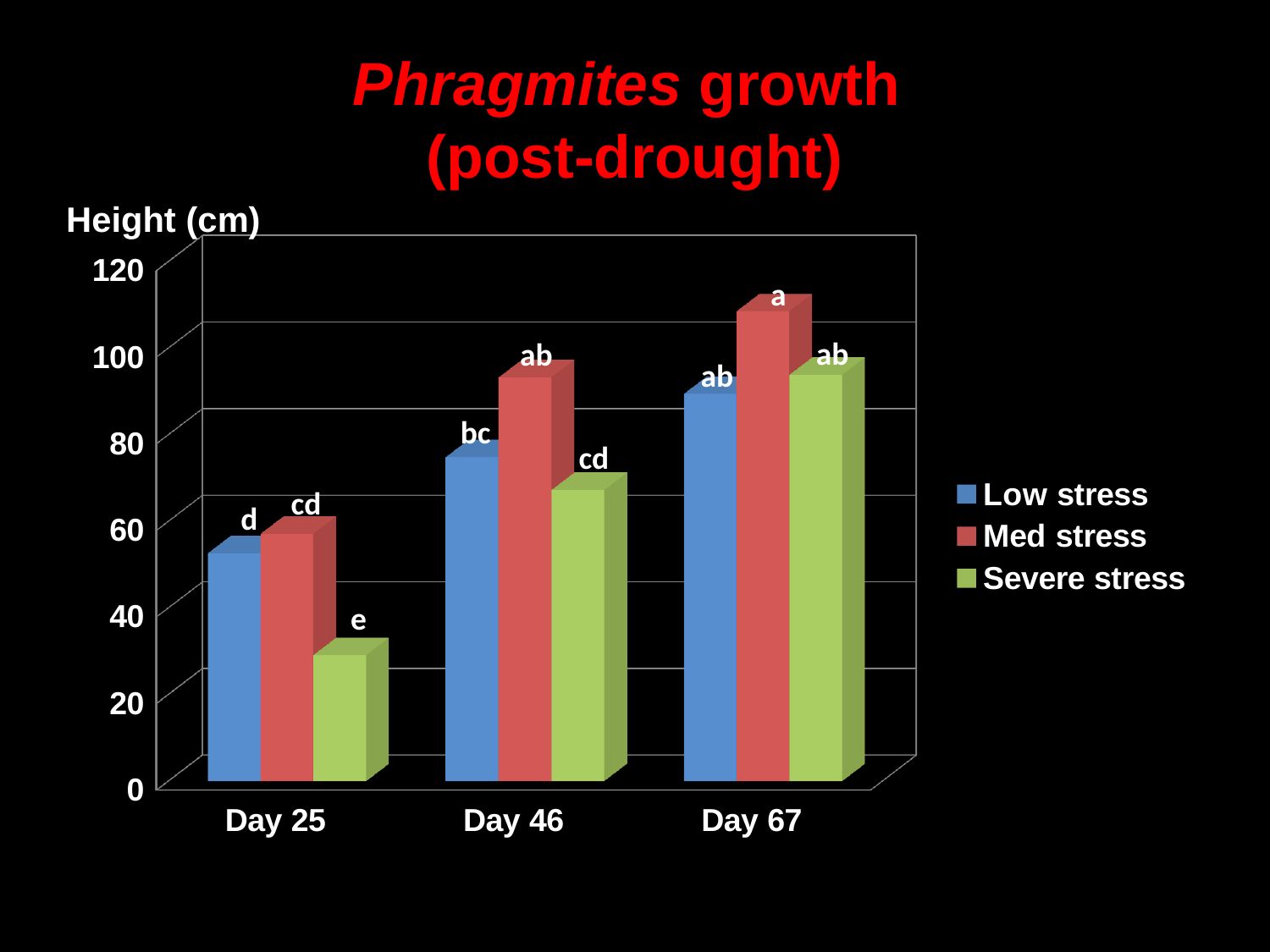
Do the Med stress values rise or fall from Day 25 to Day 67? rise What is the label on the vertical axis of the chart? Height (cm) Is the value for Severe stress at Day 25 greater or less than 40? less Which bar is the shortest in the chart? Severe stress at Day 25 How many day categories are shown on the x axis? 3 How many series does the legend list? 3 Is the value for Low stress at Day 46 greater or less than 60? greater Is the value for Med stress at Day 67 greater or less than 100? greater At Day 25, which is larger: Low stress or Severe stress? Low stress At Day 46, which is larger: Med stress or Severe stress? Med stress What kind of chart is shown on the slide? bar chart Which bar is the tallest in the chart? Med stress at Day 67